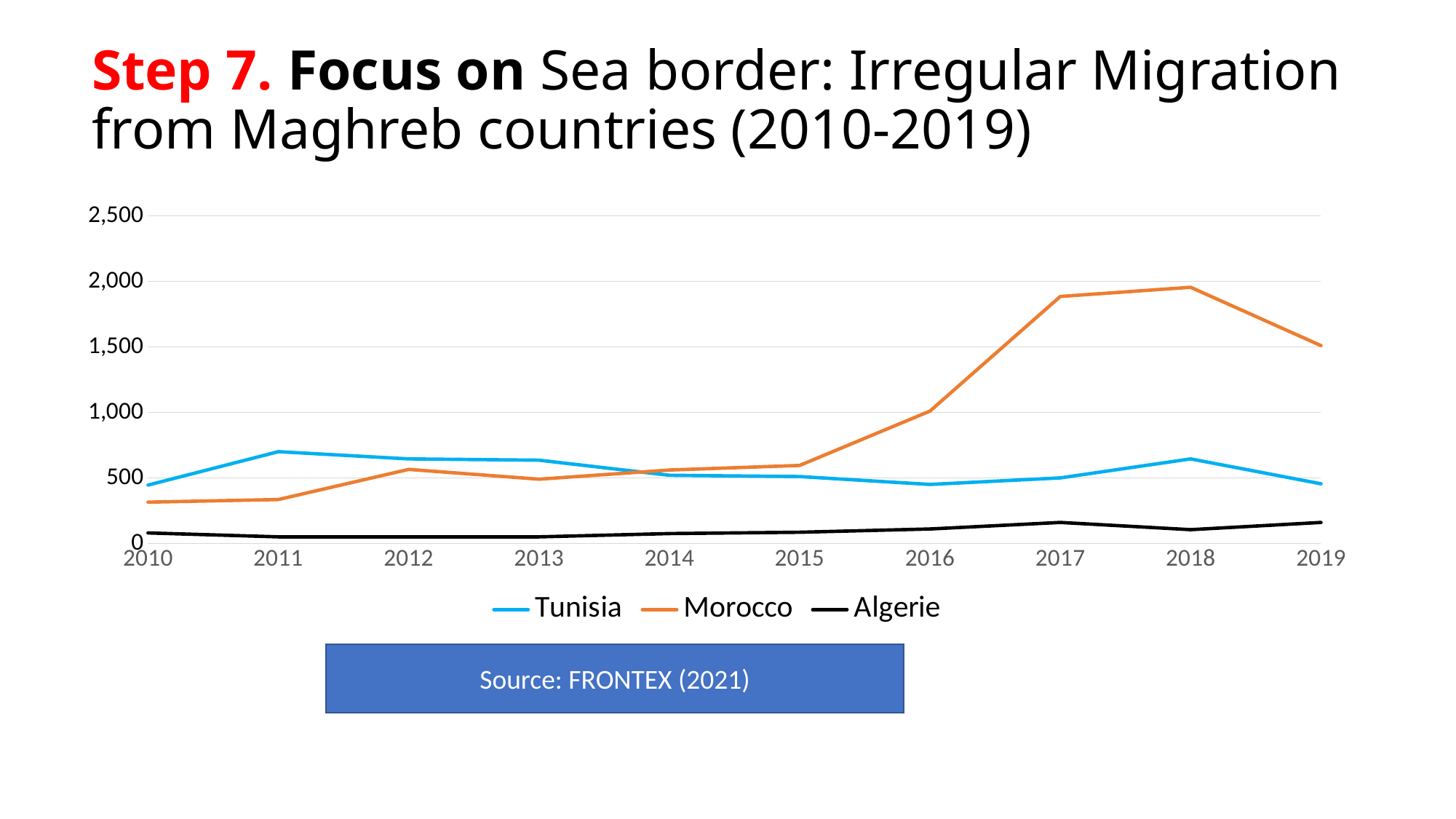
Does the Morocco line rise or fall between 2015 and 2018? rise Is the value for Morocco in 2018 greater or less than 1,500? greater Is the value for Morocco in 2010 greater or less than 500? less Which series has the lowest value in 2019? Algerie Which series has the highest value in 2018? Morocco What source is cited below the chart? FRONTEX (2021) Which is larger in 2019, the value for Morocco or the value for Tunisia? Morocco Which is larger in 2010, the value for Tunisia or the value for Morocco? Tunisia How many series does the legend list? 3 What kind of chart is shown on the slide? line chart Is the value for Tunisia in 2011 greater or less than 500? greater How many years are plotted along the x axis? 10